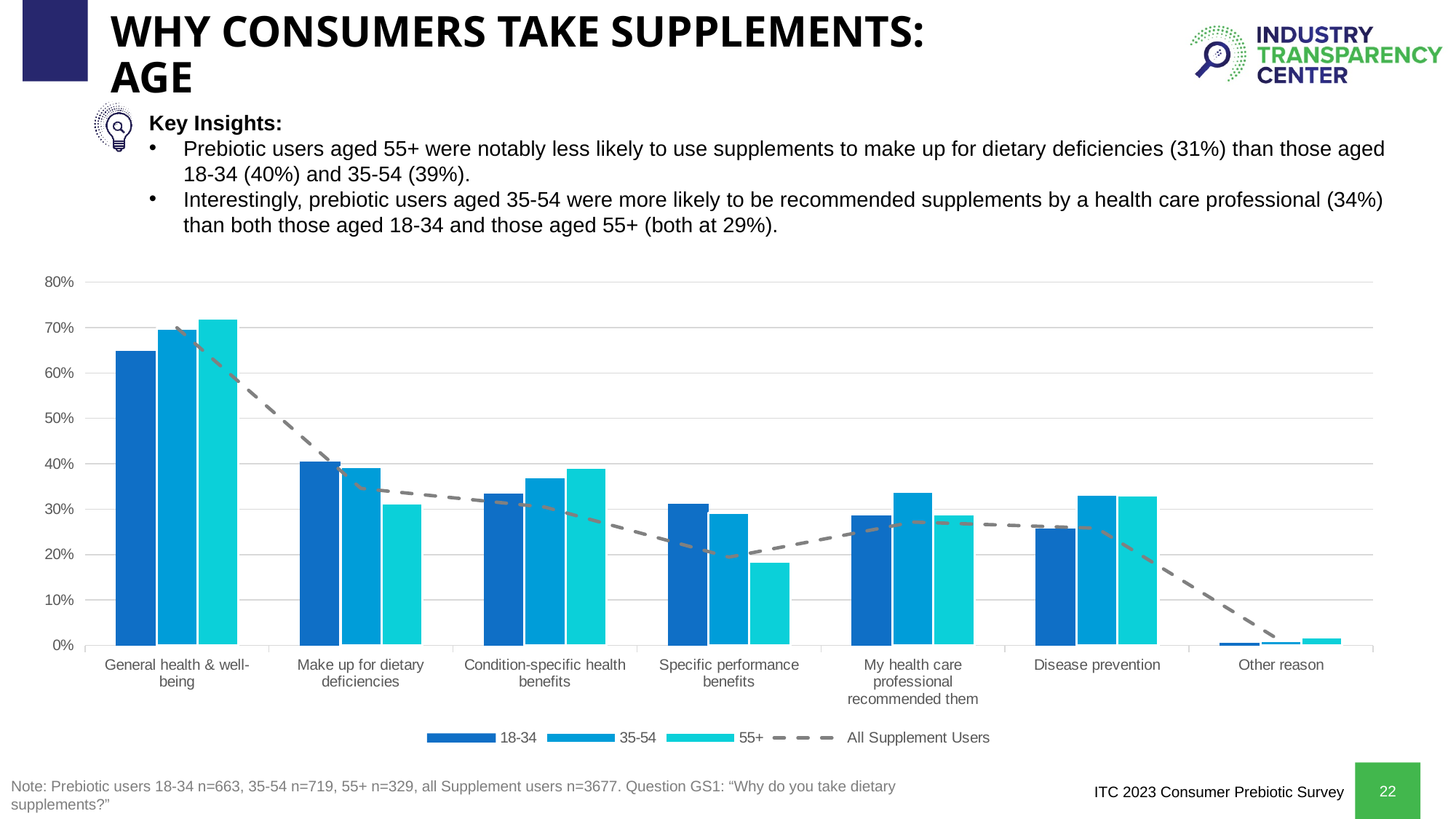
How many reason categories are shown on the x axis of the chart? 7 Is the value for 55+ in 'Specific performance benefits' greater or less than 20%? less For 'General health & well-being', which is larger: the 18-34 bar or the 55+ bar? 55+ Is the value for 18-34 in 'General health & well-being' greater or less than 60%? greater Which reason category has the highest value for the 55+ group? General health & well-being For 'Specific performance benefits', which is larger: the 18-34 bar or the 55+ bar? 18-34 Does the 'All Supplement Users' dashed line generally rise or fall from left to right across the categories? fall How many series does the chart legend list? 4 Which series in the legend is drawn as a dashed line rather than bars? All Supplement Users Which reason category has the lowest value for the 18-34 group? Other reason What kind of chart is shown on the slide? combination bar and line chart Is the value for 18-34 in 'Disease prevention' greater or less than 20%? greater